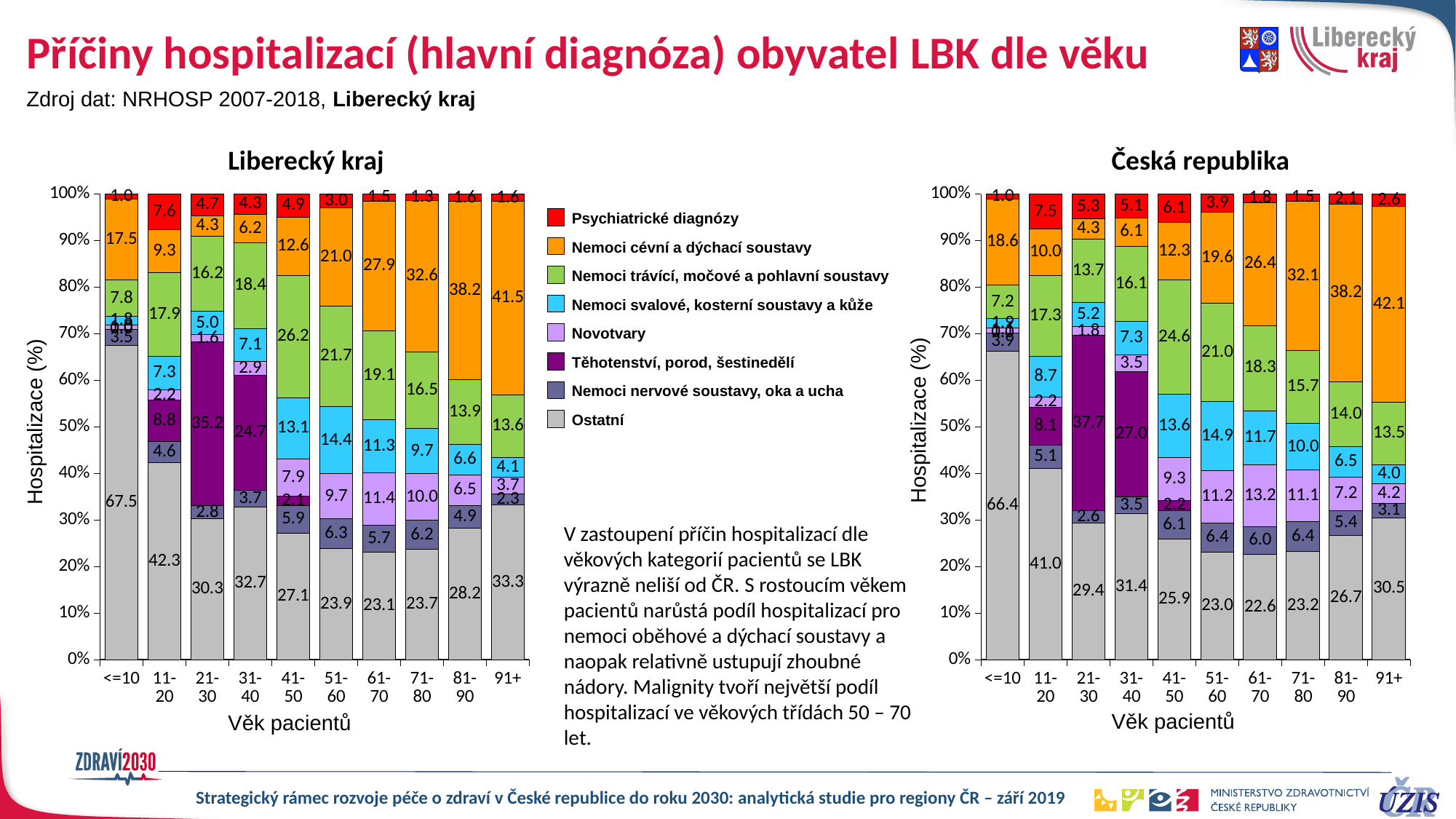
What kind of chart is the Česká republika chart? stacked bar chart In the Liberecký kraj chart, does the value for Nemoci cévní a dýchací soustavy rise or fall from the 41-50 age group to the 91+ age group? rise In the Liberecký kraj chart, what is the value for Ostatní in the <=10 age group? 67.5 In the Liberecký kraj chart, which age group has the highest value for Nemoci cévní a dýchací soustavy? 91+ In the Liberecký kraj chart, what is the difference between the Nemoci cévní a dýchací soustavy values for the 91+ and 81-90 age groups? 3.3 In the Česká republika chart, which age group has the lowest value for Ostatní? 61-70 In the Česká republika chart, what is the value for Nemoci cévní a dýchací soustavy in the 91+ age group? 42.1 In the Česká republika chart, what is the value for Novotvary in the 61-70 age group? 13.2 In the Česká republika chart, which is larger: Nemoci trávící, močové a pohlavní soustavy in the 41-50 group or in the 51-60 group? 41-50 How many series does the legend list? 8 In the Liberecký kraj chart, what is the value for Těhotenství, porod, šestinedělí in the 21-30 age group? 35.2 How many age groups are shown on the x axis of the Liberecký kraj chart? 10